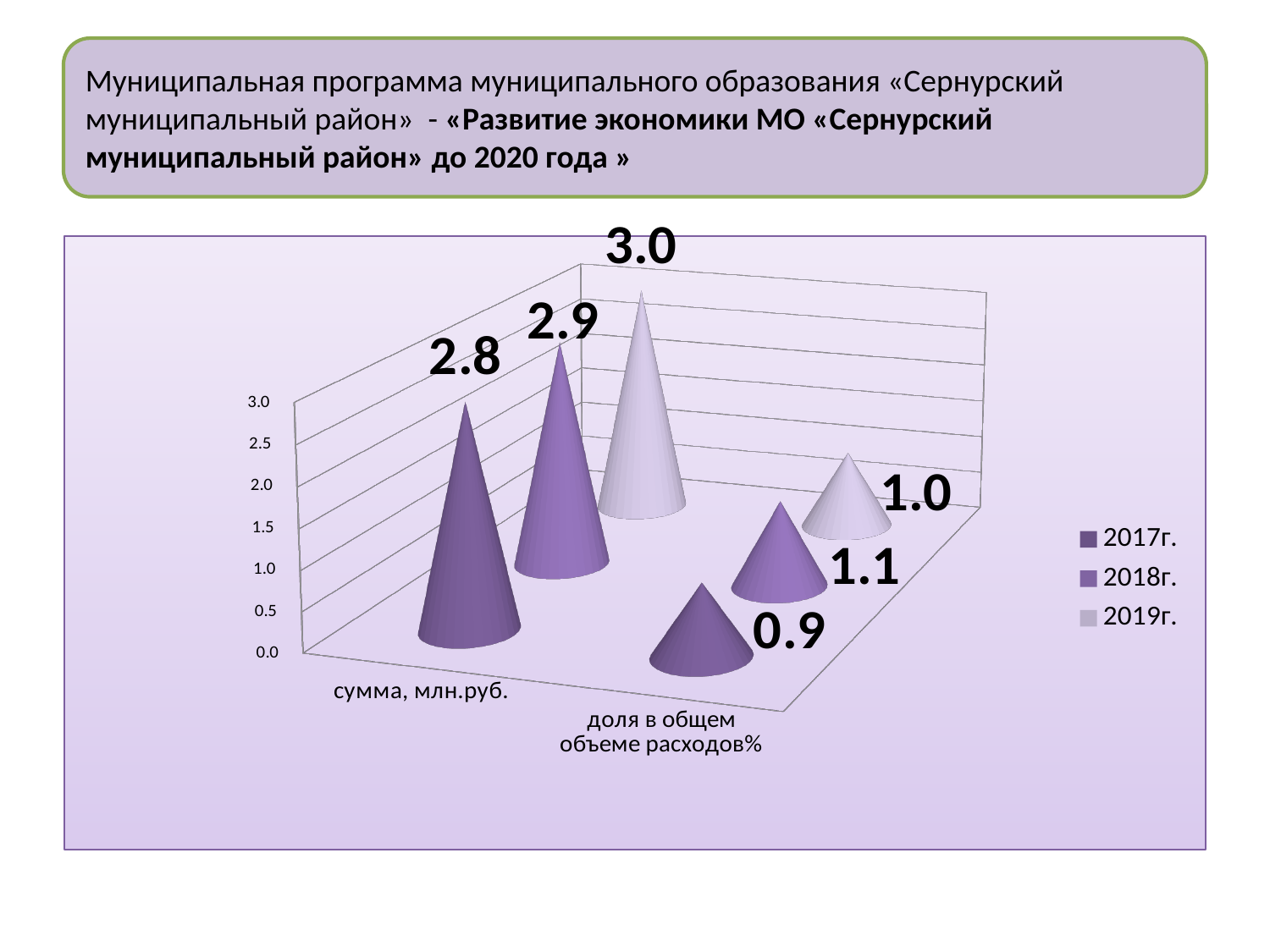
What is the difference between the 2019г. and 2017г. values in the category "сумма, млн.руб."? 0.2 Which year has the lowest value in the category "доля в общем объеме расходов%"? 2017г. What kind of chart is shown on the slide? 3D bar chart (cone-shaped bars) Do the values for "сумма, млн.руб." rise or fall from 2017г. to 2019г.? rise How many series does the legend list? 3 What is the value for 2018г. in the category "доля в общем объеме расходов%"? 1.1 Which year has the highest value in the category "сумма, млн.руб."? 2019г. What is the value for 2019г. in the category "сумма, млн.руб."? 3.0 In the category "доля в общем объеме расходов%", which is larger: the value for 2018г. or for 2019г.? 2018г. What is the value for 2017г. in the category "доля в общем объеме расходов%"? 0.9 What is the value for 2017г. in the category "сумма, млн.руб."? 2.8 How many categories are shown on the x axis? 2